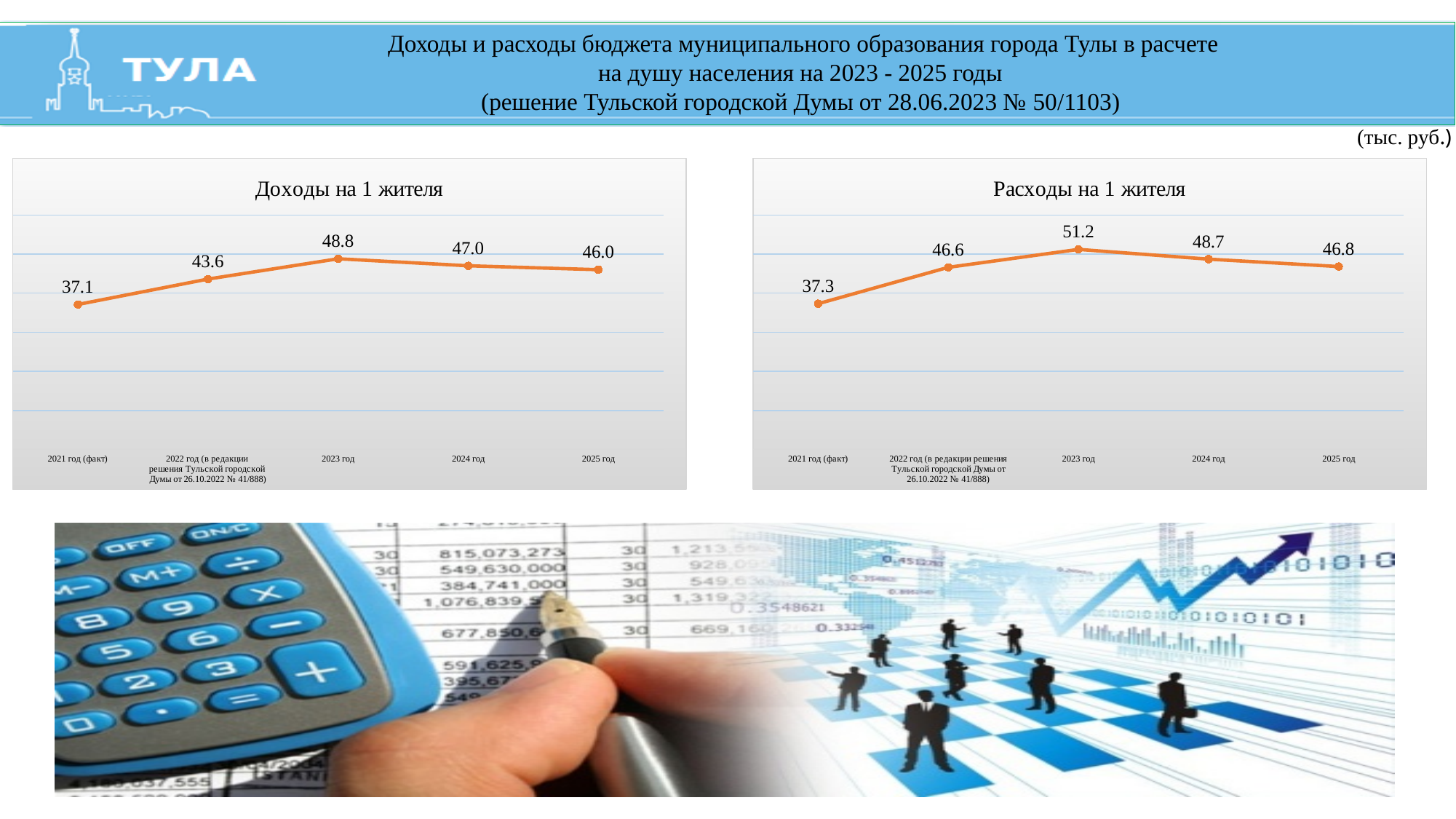
How many data points are plotted in the chart titled "Доходы на 1 жителя"? 5 In the chart titled "Доходы на 1 жителя", do the values rise or fall from 2023 год to 2025 год? Fall In the chart titled "Доходы на 1 жителя", what is the difference between the values for 2023 год and 2021 год (факт)? 11.7 In the chart titled "Расходы на 1 жителя", which year has the lowest value? 2021 год (факт) In the chart titled "Расходы на 1 жителя", what is the difference between the values for 2023 год and 2025 год? 4.4 In the chart titled "Доходы на 1 жителя", which year has the highest value? 2023 год What type of chart is the chart titled "Расходы на 1 жителя"? Line chart What unit is stated for the values on the slide? тыс. руб. In the chart titled "Расходы на 1 жителя", which is larger: the value for 2024 год or the value for 2025 год? 2024 год In the chart titled "Расходы на 1 жителя", what is the value for 2024 год? 48.7 In the chart titled "Доходы на 1 жителя", what is the value for 2023 год? 48.8 In the chart titled "Расходы на 1 жителя", what is the value for 2021 год (факт)? 37.3